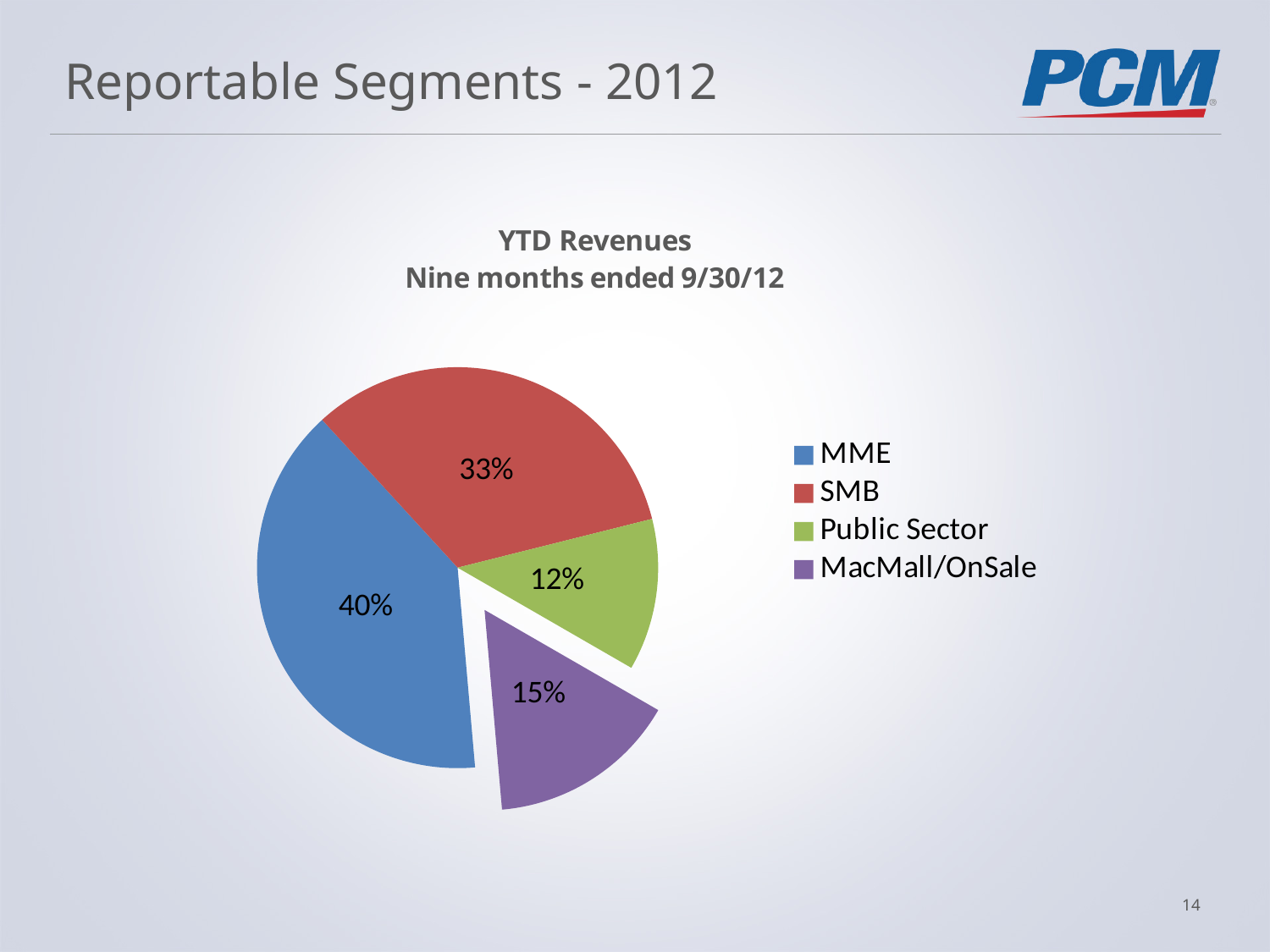
What share of YTD revenues does Public Sector account for? 12% What is the title of the chart? YTD Revenues Nine months ended 9/30/12 How many segments are shown in the pie chart? 4 Which has a larger share of YTD revenues, MacMall/OnSale or Public Sector? MacMall/OnSale What share of YTD revenues does SMB account for? 33% What type of chart is shown on the slide? Pie chart What is the difference in percentage points between the MME and SMB shares? 7 What share of YTD revenues does MacMall/OnSale account for? 15% What share of YTD revenues does MME account for? 40% Which segment has the smallest share of YTD revenues? Public Sector Which segment has the largest share of YTD revenues? MME Which segment is shown in purple in the pie chart? MacMall/OnSale